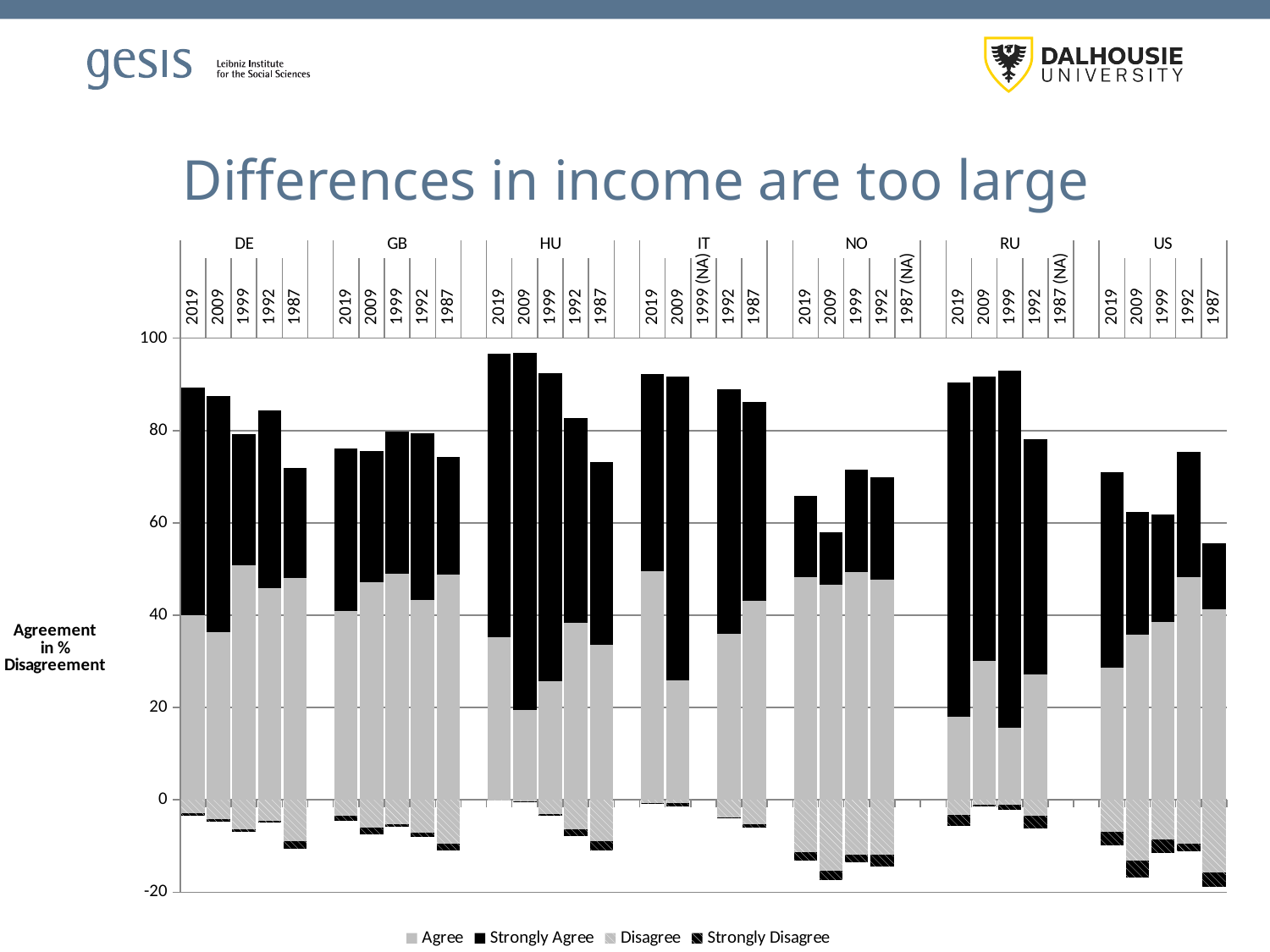
Within the HU group, do the total agreement bars rise or fall moving from left (2019) to right (1987)? fall Is the total agreement (Agree plus Strongly Agree) for HU in 2019 greater or less than 80? greater What is the title of the chart? Differences in income are too large How many country groups are shown along the x axis? 7 Is the total agreement (Agree plus Strongly Agree) for GB in 2019 greater or less than 80? less What are the four series listed in the legend? Agree, Strongly Agree, Disagree, Strongly Disagree Is the total agreement (Agree plus Strongly Agree) for US in 1987 greater or less than 60? less Which country has the highest total agreement in 2019? HU How many series does the legend list? 4 Which country has the lowest total agreement in 2019? NO What type of chart is shown on the slide? stacked bar chart